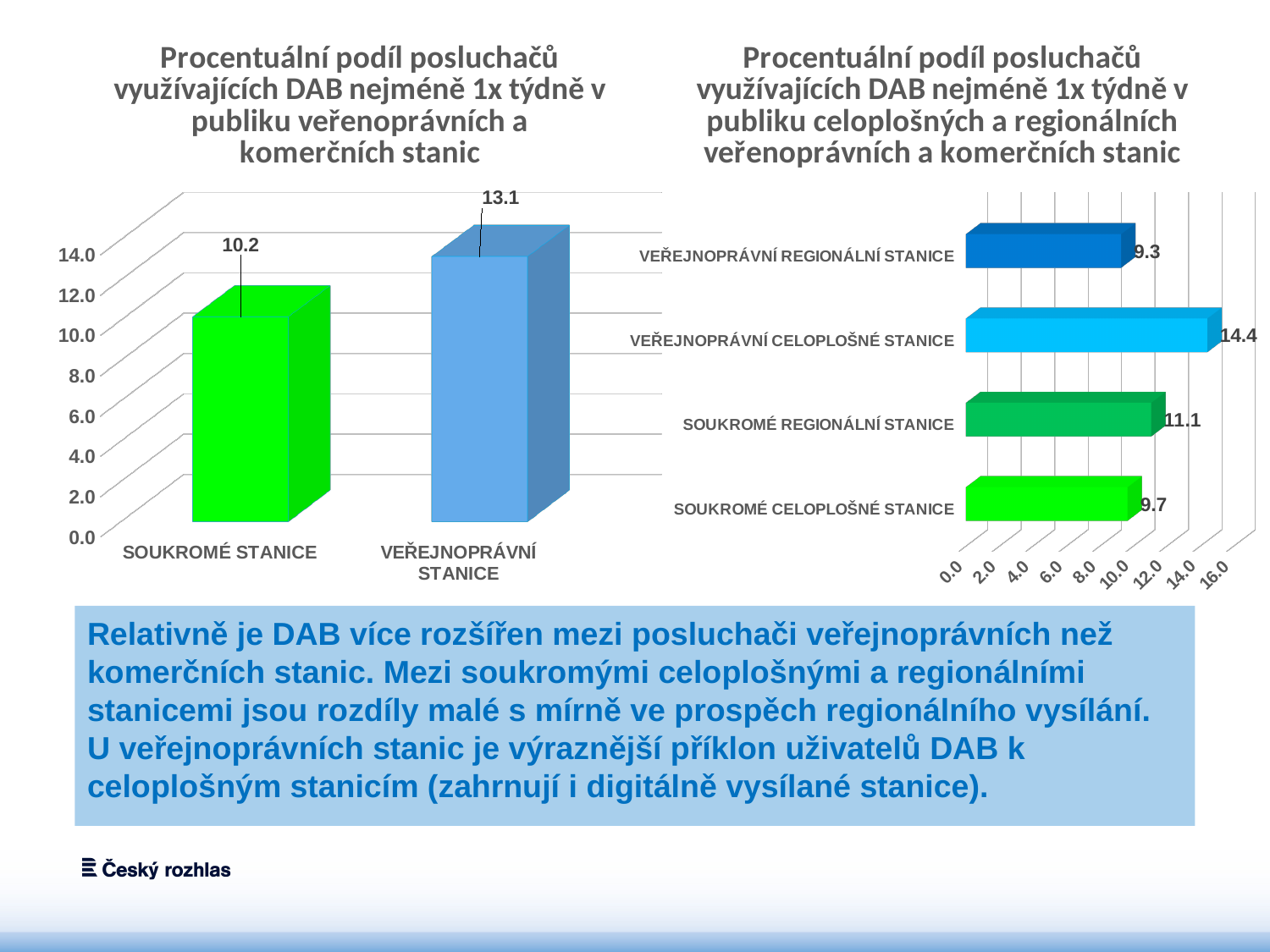
In the right chart, what is the value for SOUKROMÉ REGIONÁLNÍ STANICE? 11.1 In the right chart, what is the difference between the values for SOUKROMÉ REGIONÁLNÍ STANICE and SOUKROMÉ CELOPLOŠNÉ STANICE? 1.4 In the left chart, what is the value for VEŘEJNOPRÁVNÍ STANICE? 13.1 In the right chart, how many categories are shown? 4 In the right chart, which category has the highest value? VEŘEJNOPRÁVNÍ CELOPLOŠNÉ STANICE What kind of chart is the right chart? Bar chart In the left chart, what is the difference between the values for VEŘEJNOPRÁVNÍ STANICE and SOUKROMÉ STANICE? 2.9 In the left chart, how many categories are shown? 2 In the right chart, which category has the lowest value? VEŘEJNOPRÁVNÍ REGIONÁLNÍ STANICE In the left chart, what is the value for SOUKROMÉ STANICE? 10.2 In the left chart, which category has the higher value? VEŘEJNOPRÁVNÍ STANICE In the right chart, what is the value for VEŘEJNOPRÁVNÍ CELOPLOŠNÉ STANICE? 14.4